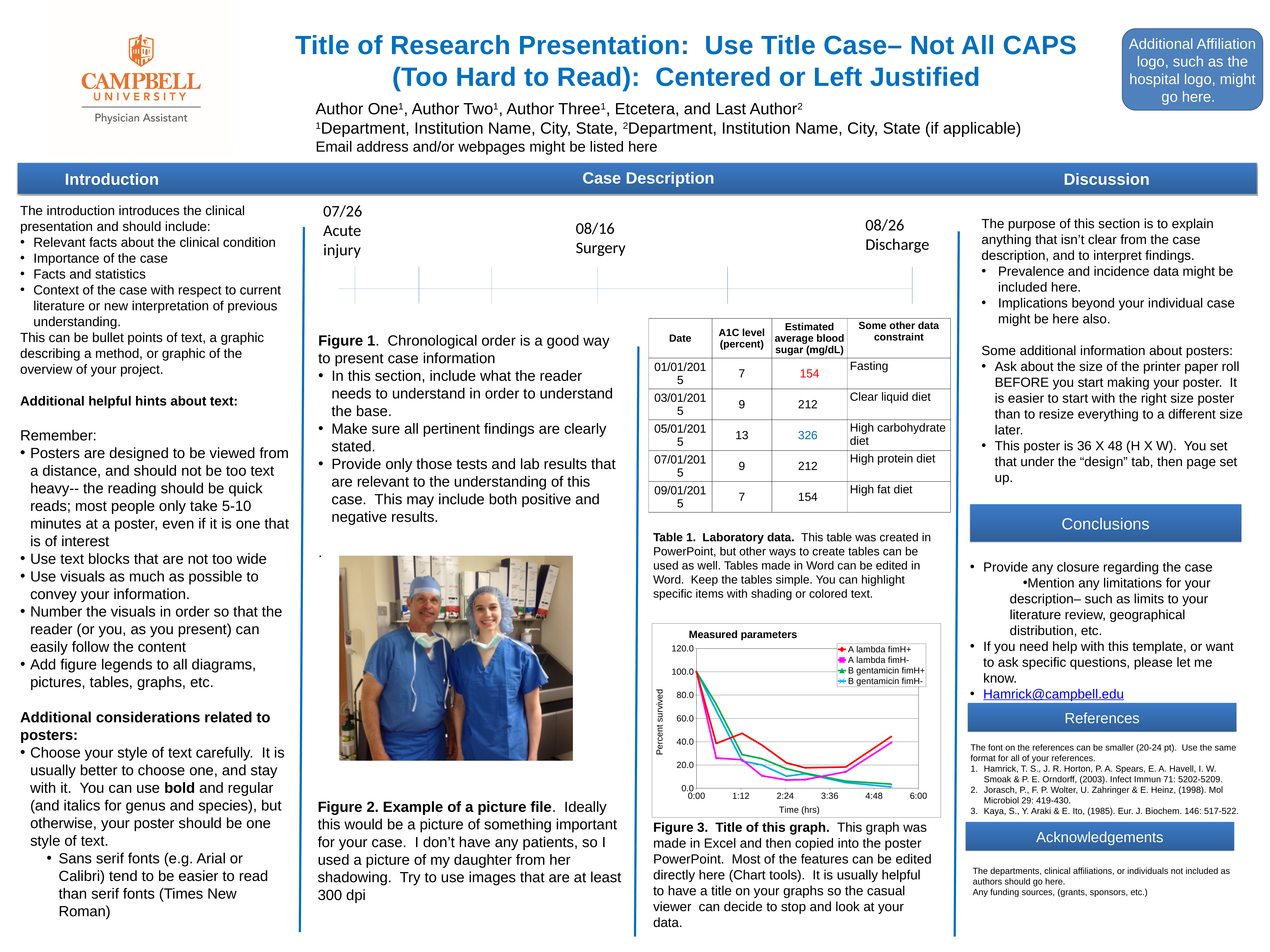
In the "Measured parameters" chart, which series has the highest value at the final time point? A lambda fimH+ In the "Measured parameters" chart, which series has the higher value at 1:12: A lambda fimH+ or A lambda fimH-? A lambda fimH+ In the "Measured parameters" chart, is the value for A lambda fimH+ at 2:24 greater or less than 40.0? less In the "Measured parameters" chart, is the value for A lambda fimH- at 1:12 greater or less than 40.0? less What is the title of the chart in Figure 3? Measured parameters What is the y-axis label of the "Measured parameters" chart? Percent survived In the "Measured parameters" chart, does the B gentamicin fimH+ series rise or fall over time? fall In the "Measured parameters" chart, is the value for B gentamicin fimH+ at 4:48 greater or less than 20.0? less In the "Measured parameters" chart, what is the value of A lambda fimH+ at time 0:00? 100.0 What kind of chart is the "Measured parameters" chart? line chart How many series does the legend of the "Measured parameters" chart list? 4 In the "Measured parameters" chart, which series has the higher value at the final time point: A lambda fimH+ or B gentamicin fimH+? A lambda fimH+